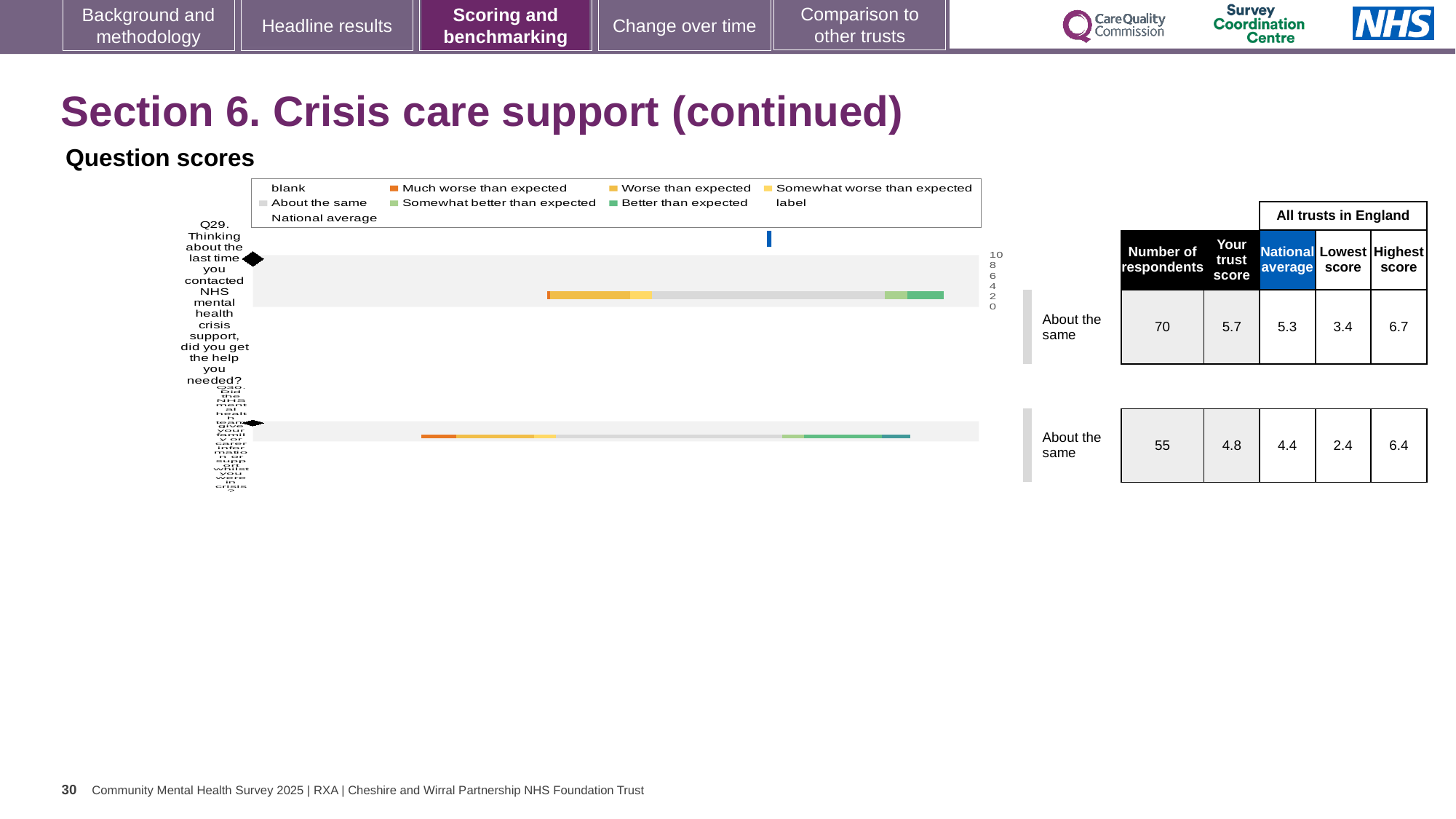
What is the trust score for Q30, the second question in the chart? 4.8 Which question has the higher trust score, Q29 or Q30? Q29 What is the difference between the highest and lowest scores in England for Q30? 4.0 What is the difference between the trust score and the national average for Q29? 0.4 How many questions (rows) are plotted in the question scores chart? 2 How many respondents answered Q29? 70 What is the highest score among all trusts in England for Q30? 6.4 What is the national average score for Q29? 5.3 What is the trust score for Q29 (Thinking about the last time you contacted NHS mental health crisis support, did you get the help you needed?)? 5.7 How many entries does the legend of the question scores chart list? 9 What type of chart is used to show the question scores on this slide? bar chart What benchmark category is given for both Q29 and Q30 in the chart? About the same